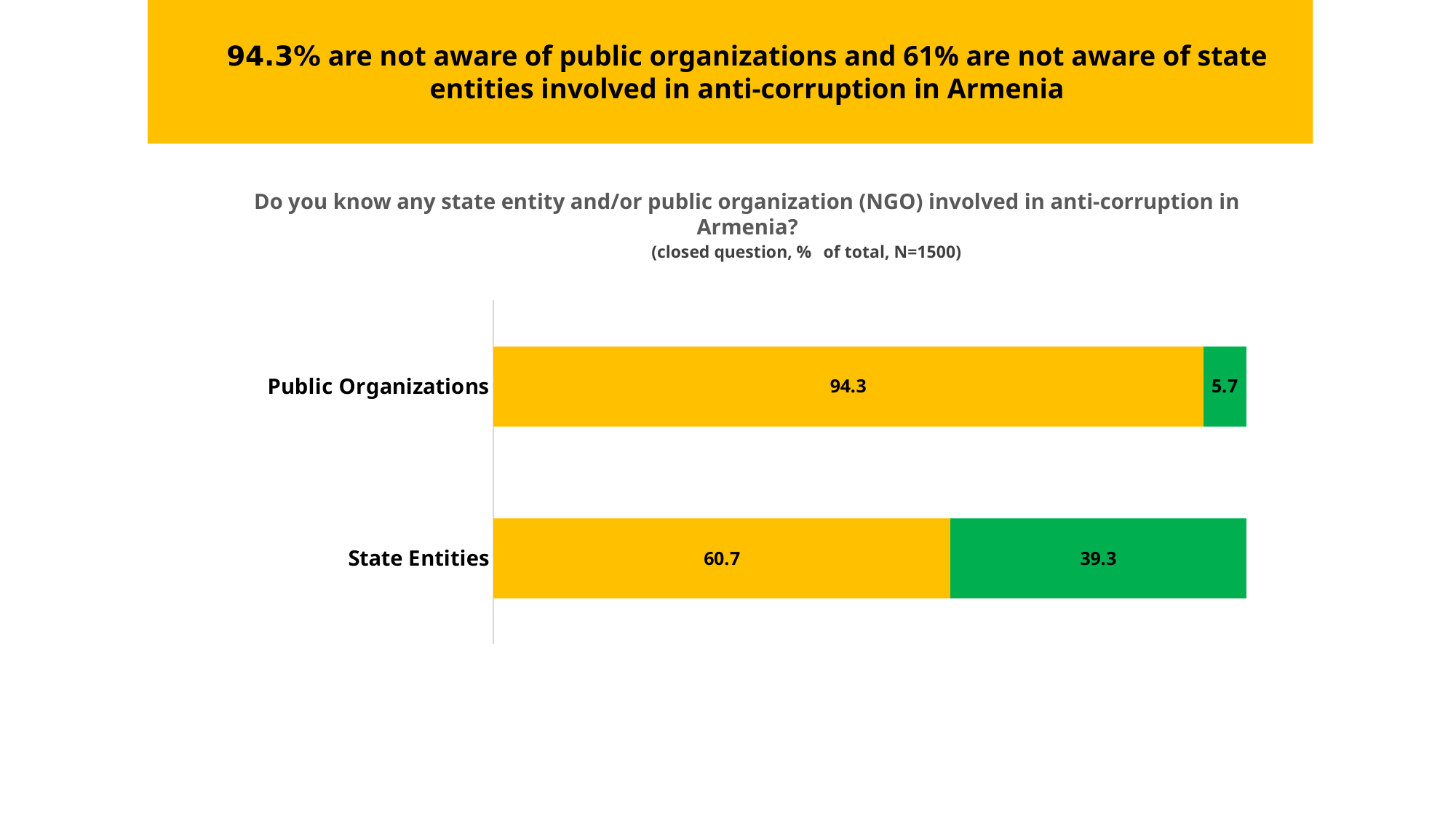
What kind of chart is shown on the slide? Bar chart Which category has the smallest green segment? Public Organizations What is the difference between the green segment values for State Entities and Public Organizations? 33.6 What value is shown on the green segment of the Public Organizations bar? 5.7 What is the difference between the yellow segment values for Public Organizations and State Entities? 33.6 What value is shown on the green segment of the State Entities bar? 39.3 What value is shown on the yellow segment of the Public Organizations bar? 94.3 How many categories are shown on the chart? 2 Which category has the larger yellow segment, Public Organizations or State Entities? Public Organizations What sample size (N) is stated in the chart subtitle? N=1500 What value is shown on the yellow segment of the State Entities bar? 60.7 What is the total of the two segments in the State Entities bar? 100